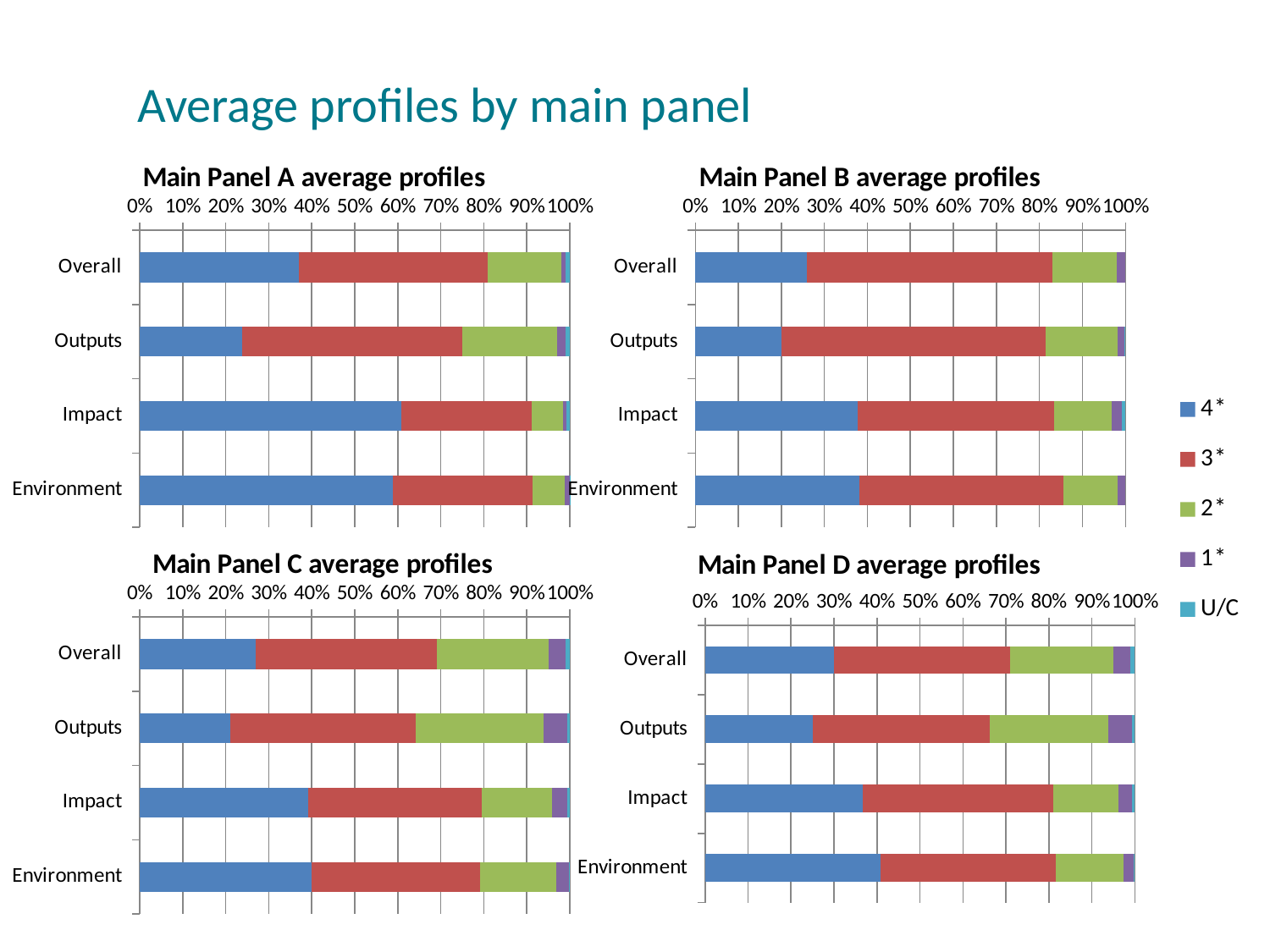
In the Main Panel B average profiles chart, which category has the lowest 4* share? Outputs What kind of chart is the Main Panel A average profiles chart? Stacked bar chart In the Main Panel A average profiles chart, which category has the lowest 4* share? Outputs How many categories are shown on the Main Panel C average profiles chart? 4 In the Main Panel C average profiles chart, which has the larger 4* share, Impact or Overall? Impact What are the legend entries shown on the slide? 4*, 3*, 2*, 1*, U/C In the Main Panel A average profiles chart, is the 4* value for Impact greater or less than 50%? greater In the Main Panel D average profiles chart, is the 4* value for Environment greater or less than 30%? greater In the Main Panel A average profiles chart, which has the larger 4* share, Impact or Outputs? Impact In the Main Panel B average profiles chart, is the 4* value for Outputs greater or less than 30%? less In the Main Panel C average profiles chart, which category has the lowest 4* share? Outputs How many series does the shared legend list? 5